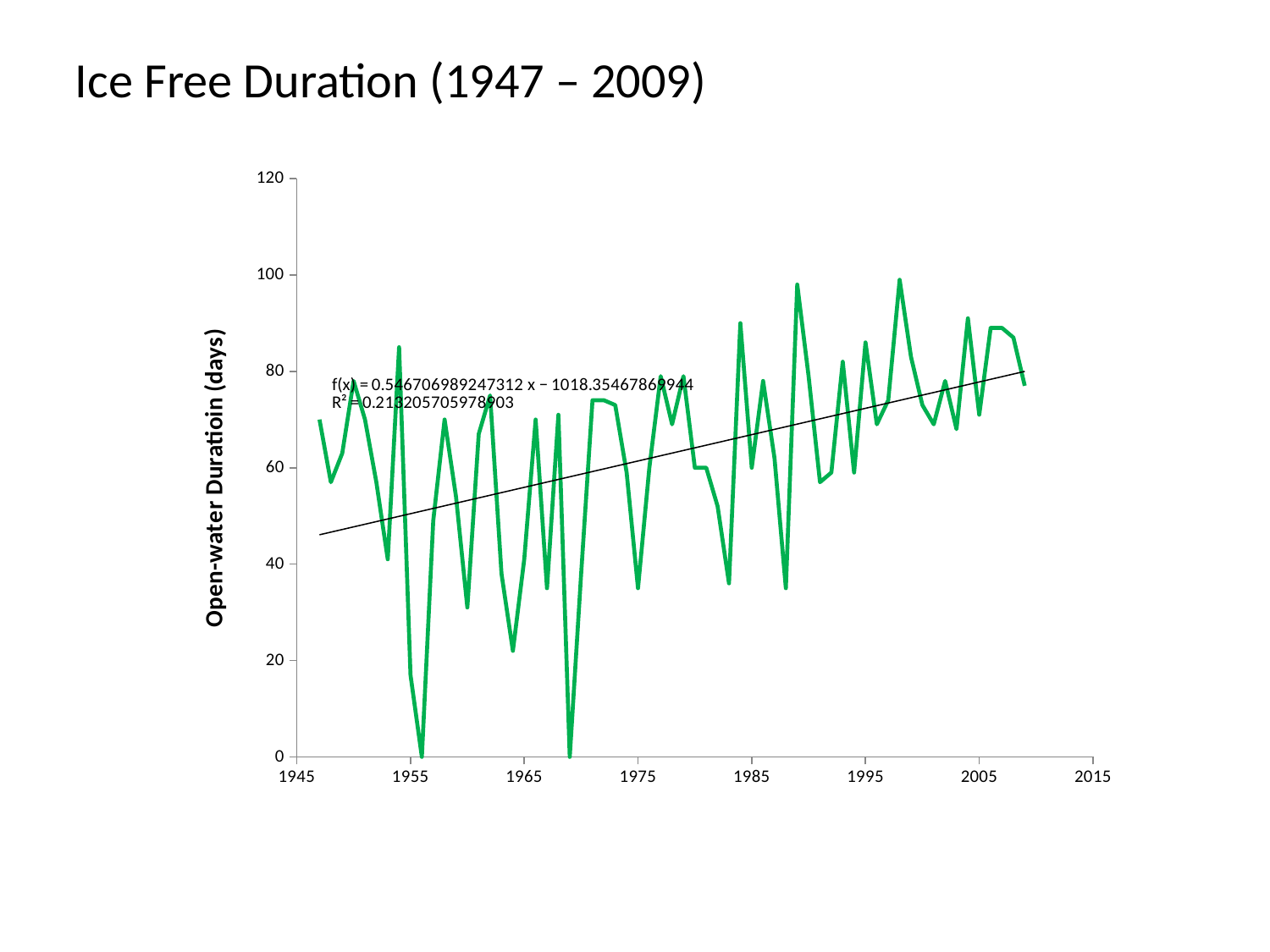
What is the R² value printed on the chart? 0.213205705978903 Is the value for the peak around 1984 greater or less than 80? greater Does the fitted trend line show open-water duration rising or falling from 1947 to 2009? rising Is the value for the peak around 1998 greater or less than 80? greater What kind of chart is shown on the slide? line chart Is the value for the low point around 1969 greater or less than 20? less What is the title of the slide? Ice Free Duration (1947 – 2009)